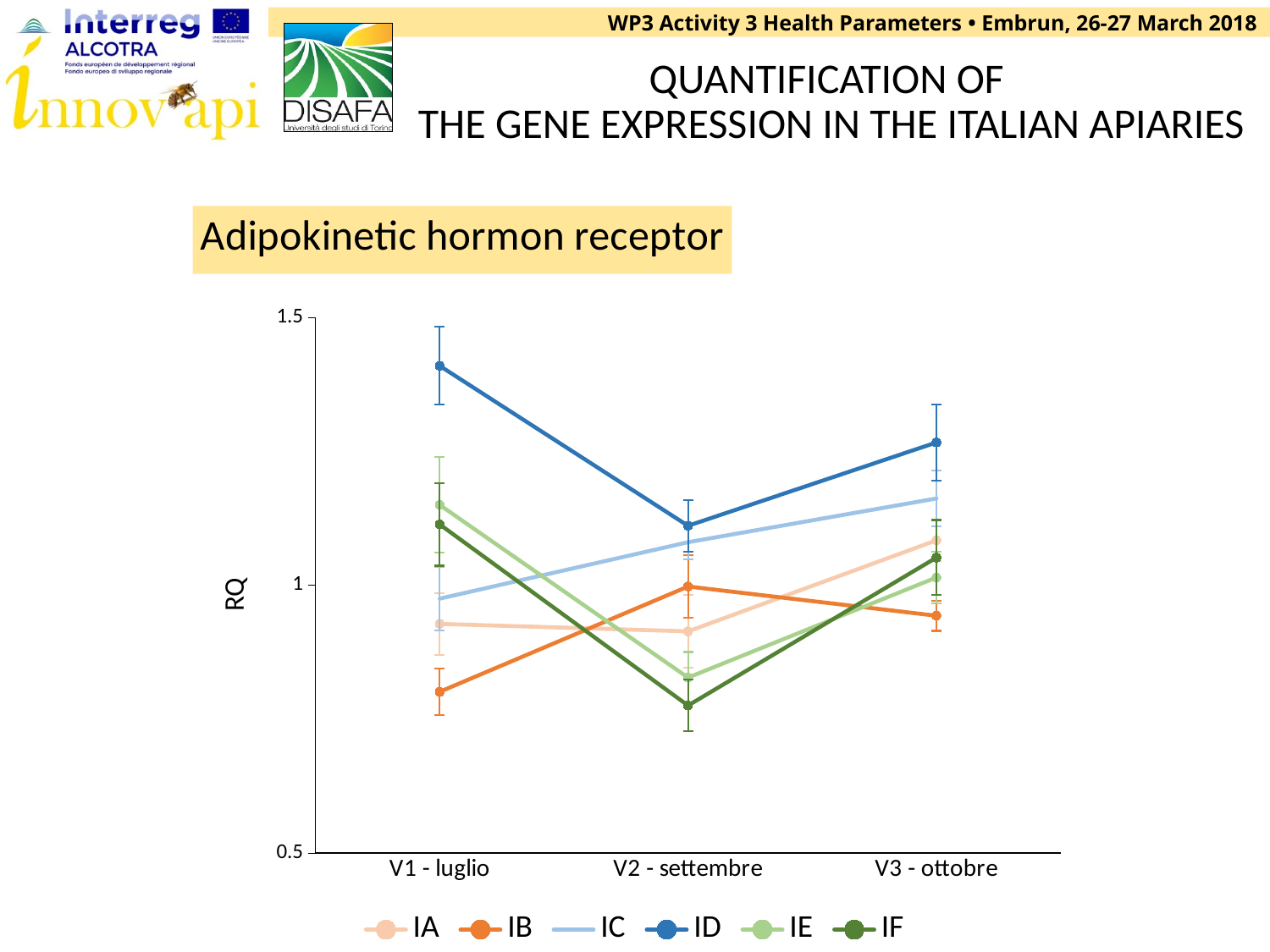
Is the value for IF at V2 - settembre greater or less than 1? less Is the value for ID at V1 - luglio greater or less than 1? greater Which series has the lowest value at V1 - luglio? IB Which series has the highest value at V3 - ottobre? ID How many series does the legend list? 6 Which series has the highest value at V1 - luglio? ID What is the label on the y axis? RQ What kind of chart is shown on the slide? line chart Is the value for IB at V1 - luglio greater or less than 1? less Does the value for ID rise or fall from V1 - luglio to V2 - settembre? fall How many categories are shown on the x axis? 3 Which is larger at V1 - luglio, the value for ID or the value for IB? ID